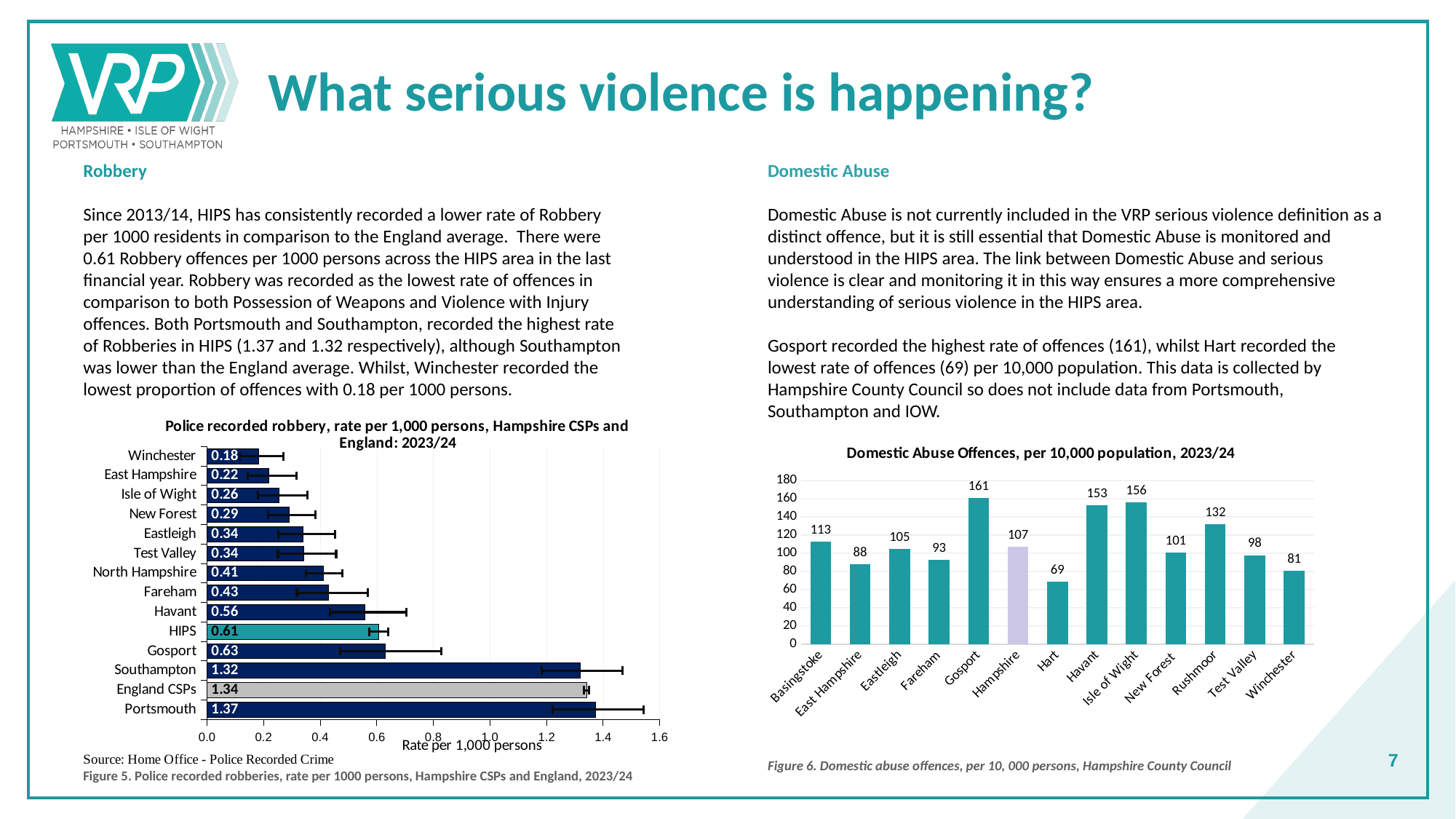
In the robbery rate chart, which area has the highest rate? Portsmouth How many areas are shown in the robbery rate chart? 14 In the robbery rate chart, which is larger, the rate for Havant or the rate for Fareham? Havant What kind of chart is the robbery rate chart? Bar chart In the robbery rate chart, what is the rate per 1,000 persons for HIPS? 0.61 How many areas are shown in the Domestic Abuse Offences chart? 13 In the robbery rate chart, what is the difference between the rates for Portsmouth and Southampton? 0.05 In the robbery rate chart, what is the rate per 1,000 persons for Winchester? 0.18 In the Domestic Abuse Offences chart, what is the value for Rushmoor? 132 In the Domestic Abuse Offences chart, which area has the lowest value? Hart In the Domestic Abuse Offences chart, which bar is shown in a different colour from the others? Hampshire In the Domestic Abuse Offences chart, what is the difference between Gosport and Hart? 92